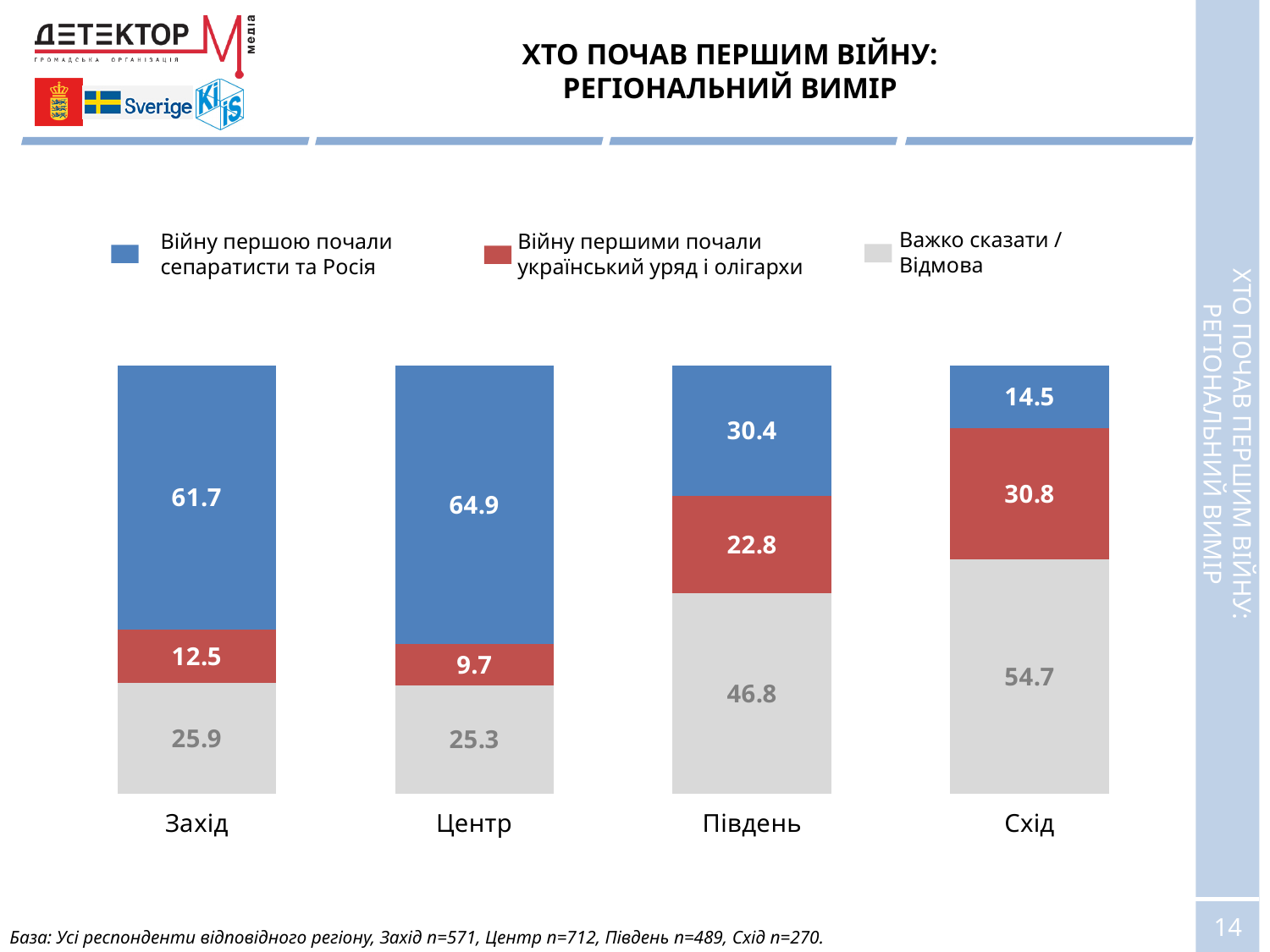
What is the value for 'Війну першими почали український уряд і олігархи' in the Південь region? 22.8 What is the total of the stacked bar for the Південь region? 100.0 What is the value for 'Важко сказати / Відмова' in the Схід region? 54.7 Which is larger: the 'Війну першою почали сепаратисти та Росія' value for Південь or for Схід? Південь Which series is shown in blue in the chart legend? Війну першою почали сепаратисти та Росія What is the difference between the 'Важко сказати / Відмова' values for Схід and Захід? 28.8 What type of chart is shown on the slide? Stacked bar chart How many series does the chart legend list? 3 Which region has the highest value for 'Війну першою почали сепаратисти та Росія'? Центр Which region has the lowest value for 'Війну першими почали український уряд і олігархи'? Центр How many regions (categories) are shown on the x axis of the chart? 4 What is the value for 'Війну першою почали сепаратисти та Росія' in the Захід region? 61.7